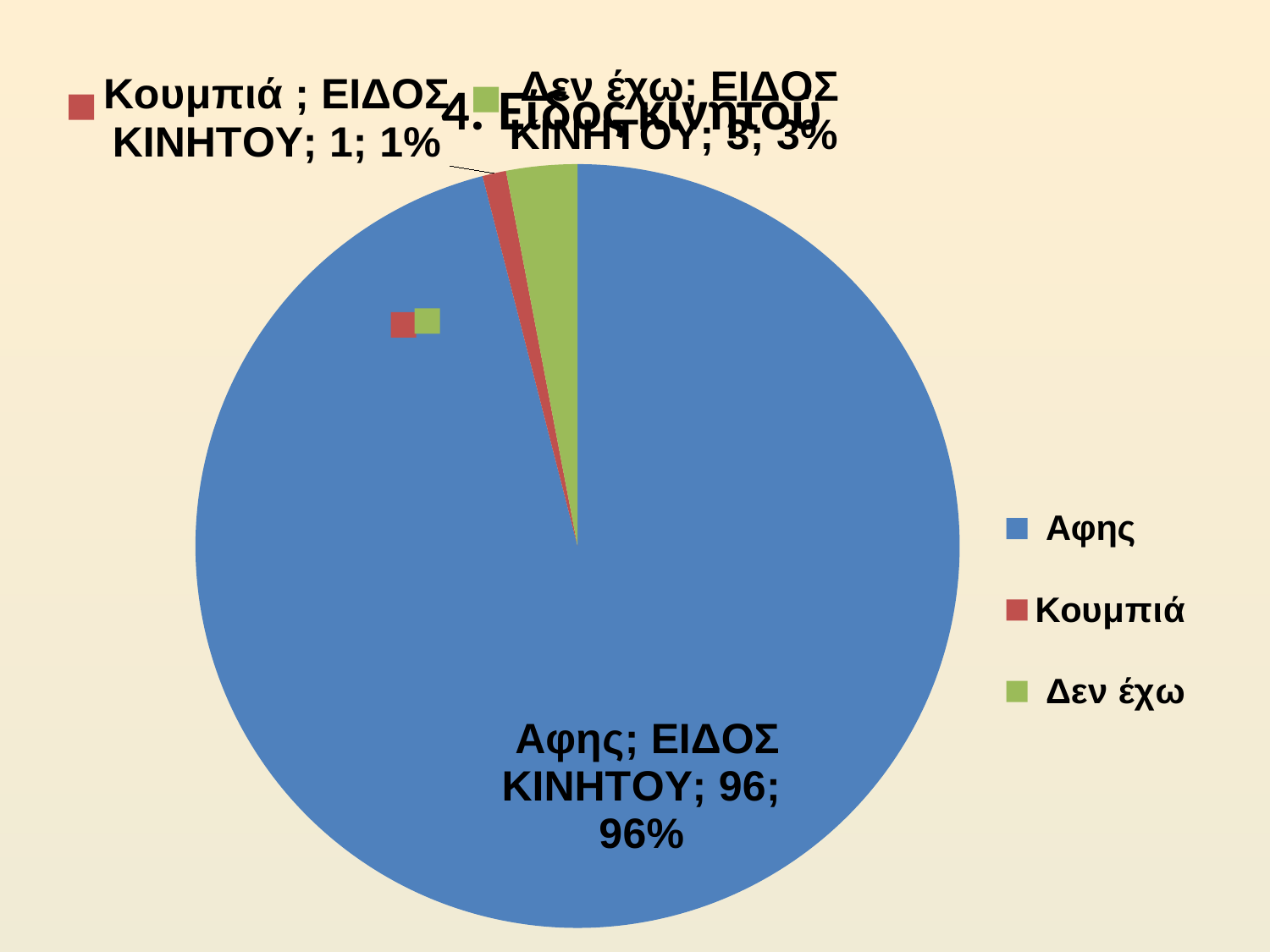
What value is shown for Αφης? 96 What is the difference between the values for Αφης and Δεν έχω? 93 What colour is the Αφης slice? blue What percentage share does the Δεν έχω slice have? 3% How many categories does the pie chart have? 3 Which category has the largest slice? Αφης What kind of chart is shown on the slide? pie chart What value is shown for Κουμπιά? 1 What value is shown for Δεν έχω? 3 What percentage share does the Αφης slice have? 96% Which is larger, the value for Δεν έχω or the value for Κουμπιά? Δεν έχω Which category has the smallest slice? Κουμπιά